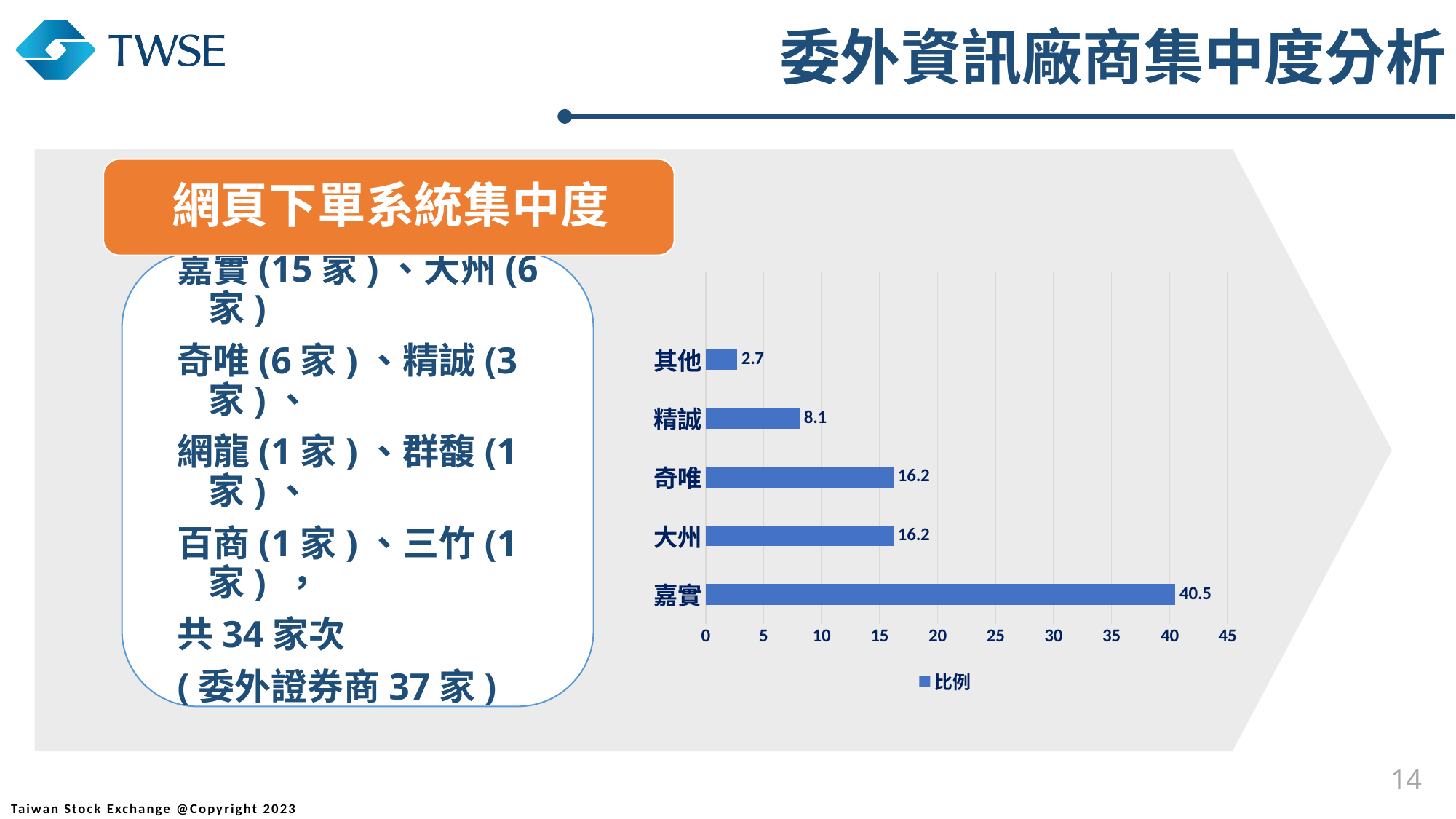
Which category has the highest value in the bar chart? 嘉實 Which is larger, the value for 精誠 or the value for 其他? 精誠 What kind of chart is shown on the slide? bar chart How many categories are shown in the bar chart? 5 How many series does the legend list? 1 What is the value for 奇唯 in the bar chart? 16.2 What is the value for 精誠 in the bar chart? 8.1 What is the value for 其他 in the bar chart? 2.7 What is the legend entry of the chart? 比例 What is the difference between the values for 嘉實 and 大州? 24.3 Which category has the lowest value in the bar chart? 其他 What is the value for 嘉實 in the bar chart? 40.5